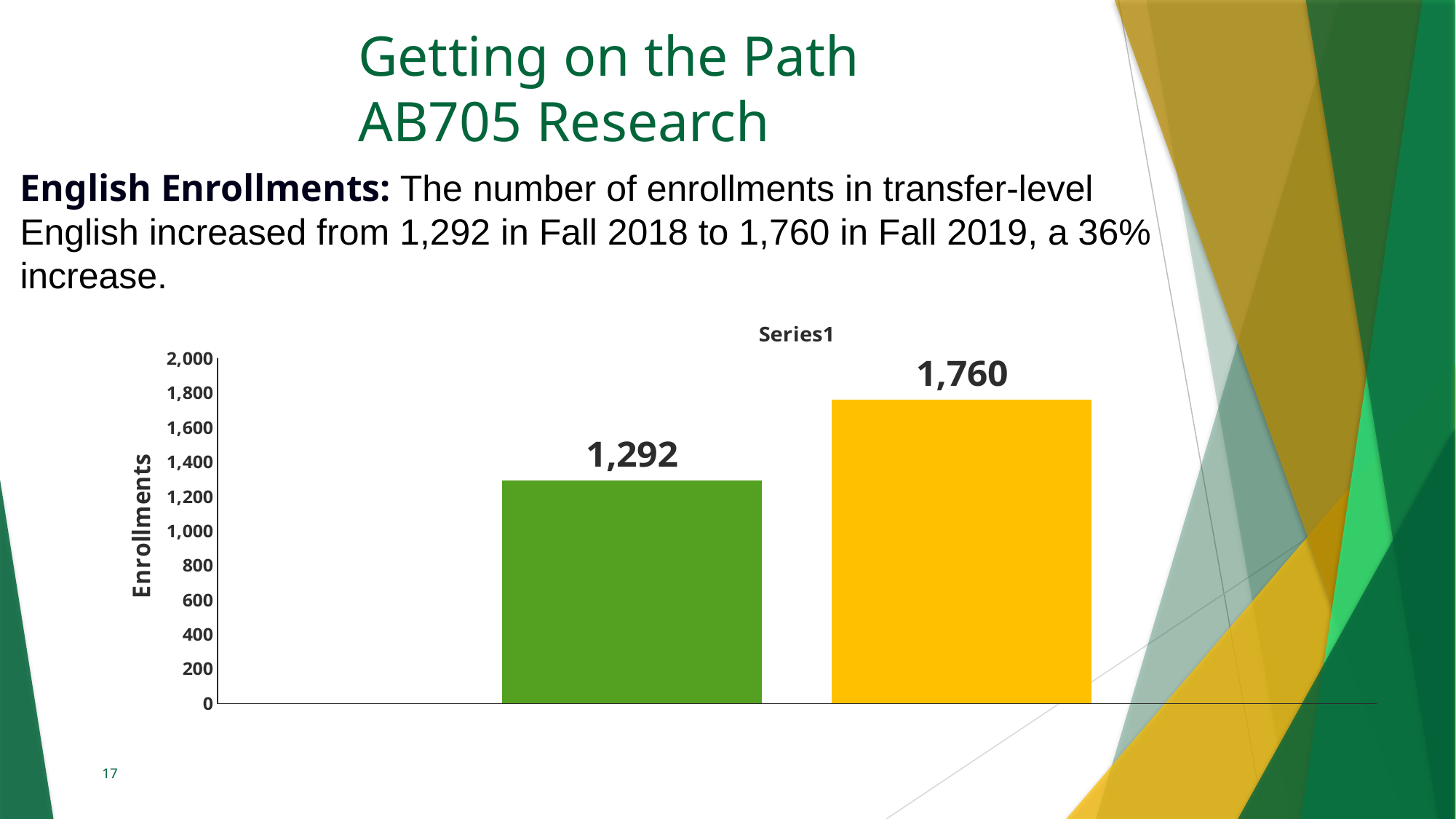
What is the label on the vertical axis of the chart? Enrollments What is the title shown above the chart? Series1 What kind of chart is shown on the slide? bar chart What is the value shown on the green bar? 1,292 What is the lowest value shown in the chart? 1,292 What is the highest value shown in the chart? 1,760 Is the value of the yellow bar greater or less than 1,600? greater How many bars are plotted in the chart? 2 What is the difference between the values of the yellow bar and the green bar? 468 Which bar has the higher value, the green bar or the yellow bar? the yellow bar Is the value of the green bar greater or less than 1,400? less What is the value shown on the yellow bar? 1,760